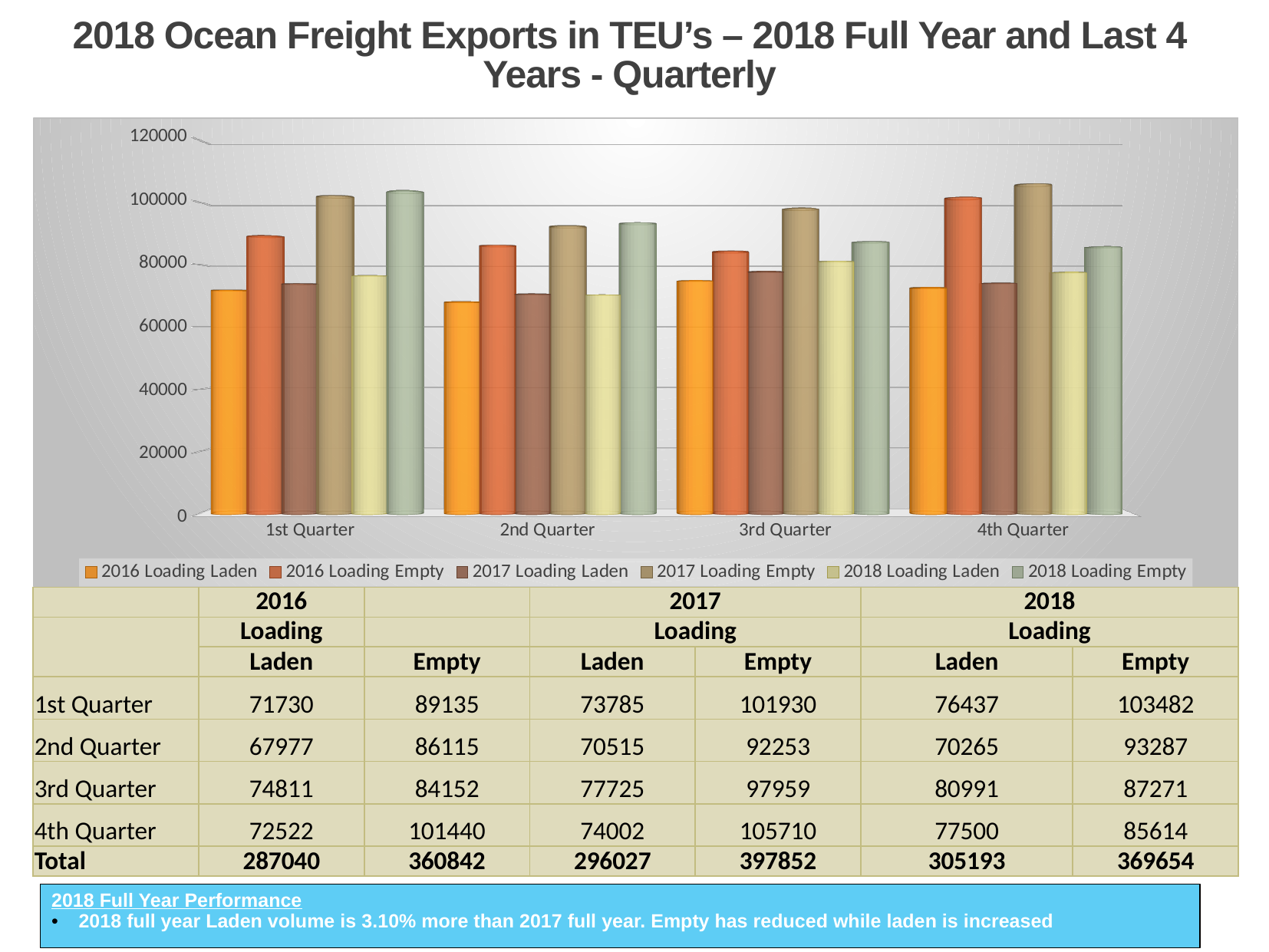
Is the value for 2018 Loading Empty in the 2nd Quarter greater or less than 100000? less Which series and quarter has the lowest bar in the chart? 2016 Loading Laden, 2nd Quarter What is the value for 2017 Loading Empty in the 4th Quarter? 105710 Do the values for 2018 Loading Empty rise or fall from the 1st Quarter to the 4th Quarter? fall What colour represents 2016 Loading Laden in the legend? orange What is the value for 2018 Loading Laden in the 3rd Quarter? 80991 In the 4th Quarter, which is larger: 2016 Loading Empty or 2017 Loading Empty? 2017 Loading Empty What kind of chart is shown on the slide? bar chart Which series and quarter has the highest bar in the chart? 2017 Loading Empty, 4th Quarter What is the difference between 2018 Loading Empty and 2018 Loading Laden in the 1st Quarter? 27045 How many quarter categories are shown on the x axis? 4 How many series does the chart legend list? 6